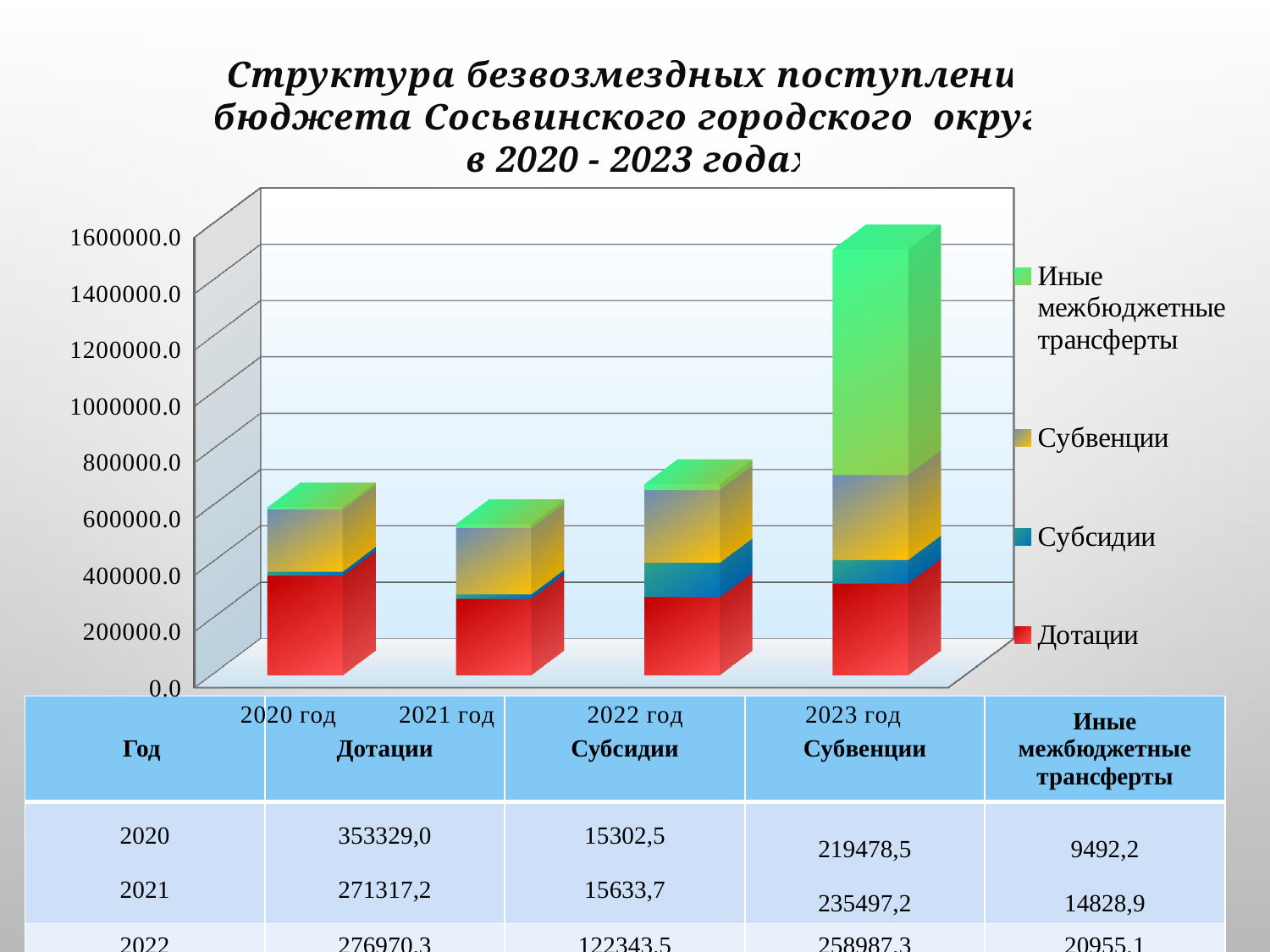
According to the table under the chart, what is the value of Дотации for 2020? 353329,0 Which year has the tallest stacked bar in the chart? 2023 год Which stacked bar is taller, 2022 год or 2023 год? 2023 год According to the table under the chart, what is the value of Субсидии for 2021? 15633,7 How many years (categories) are plotted on the x axis of the chart? 4 According to the table under the chart, by how much do Дотации in 2020 exceed Дотации in 2021? 82011,8 Which colour represents the Дотации series in the chart? red How many series does the chart legend list? 4 Which year has the shortest stacked bar in the chart? 2021 год Is the total of the stacked bar for 2023 год greater or less than 1400000.0? greater Is the total of the stacked bar for 2020 год greater or less than 800000.0? less What kind of chart is shown on the slide? stacked bar chart